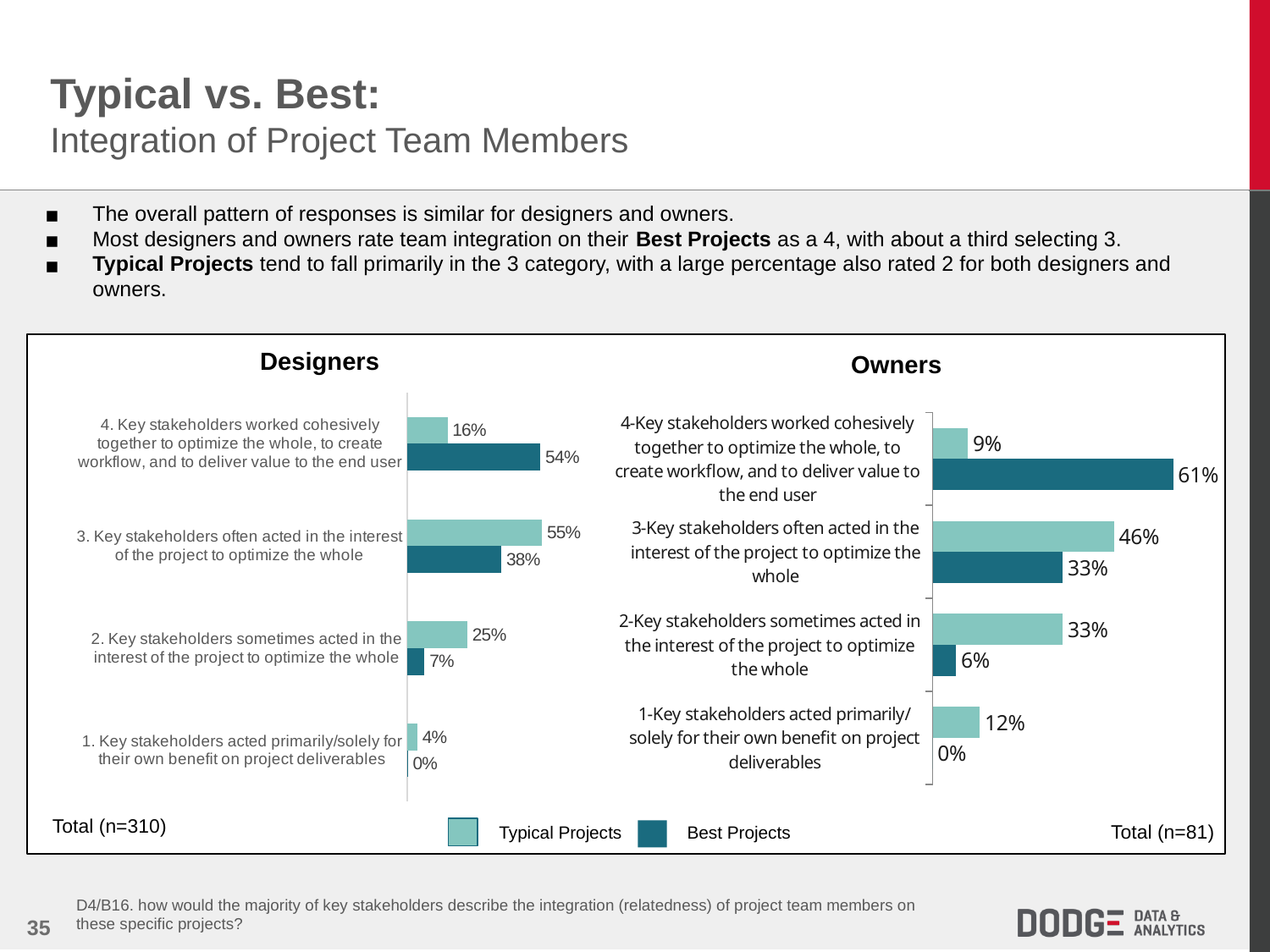
How many series does the legend list? 2 What is the sample size (n) shown for the Owners chart? n=81 In the Owners chart, which category has the lowest Best Projects value? 1-Key stakeholders acted primarily/solely for their own benefit on project deliverables In the Owners chart, what percentage of Best Projects are rated 4? 61% In the Designers chart, which category has the highest Typical Projects value? 3. Key stakeholders often acted in the interest of the project to optimize the whole In the Designers chart, what percentage of Best Projects are rated 4 (key stakeholders worked cohesively together)? 54% How many categories does the Owners chart show? 4 In the Owners chart, what percentage of Typical Projects are rated 3 (key stakeholders often acted in the interest of the project)? 46% In the Designers chart, which is larger for category 2: the Typical Projects value or the Best Projects value? Typical Projects What type of chart is the Designers chart? Bar chart In the Designers chart, what is the difference between the Best Projects and Typical Projects values for category 4? 38 percentage points In the Owners chart, what is the difference between the Typical Projects and Best Projects values for category 2? 27 percentage points